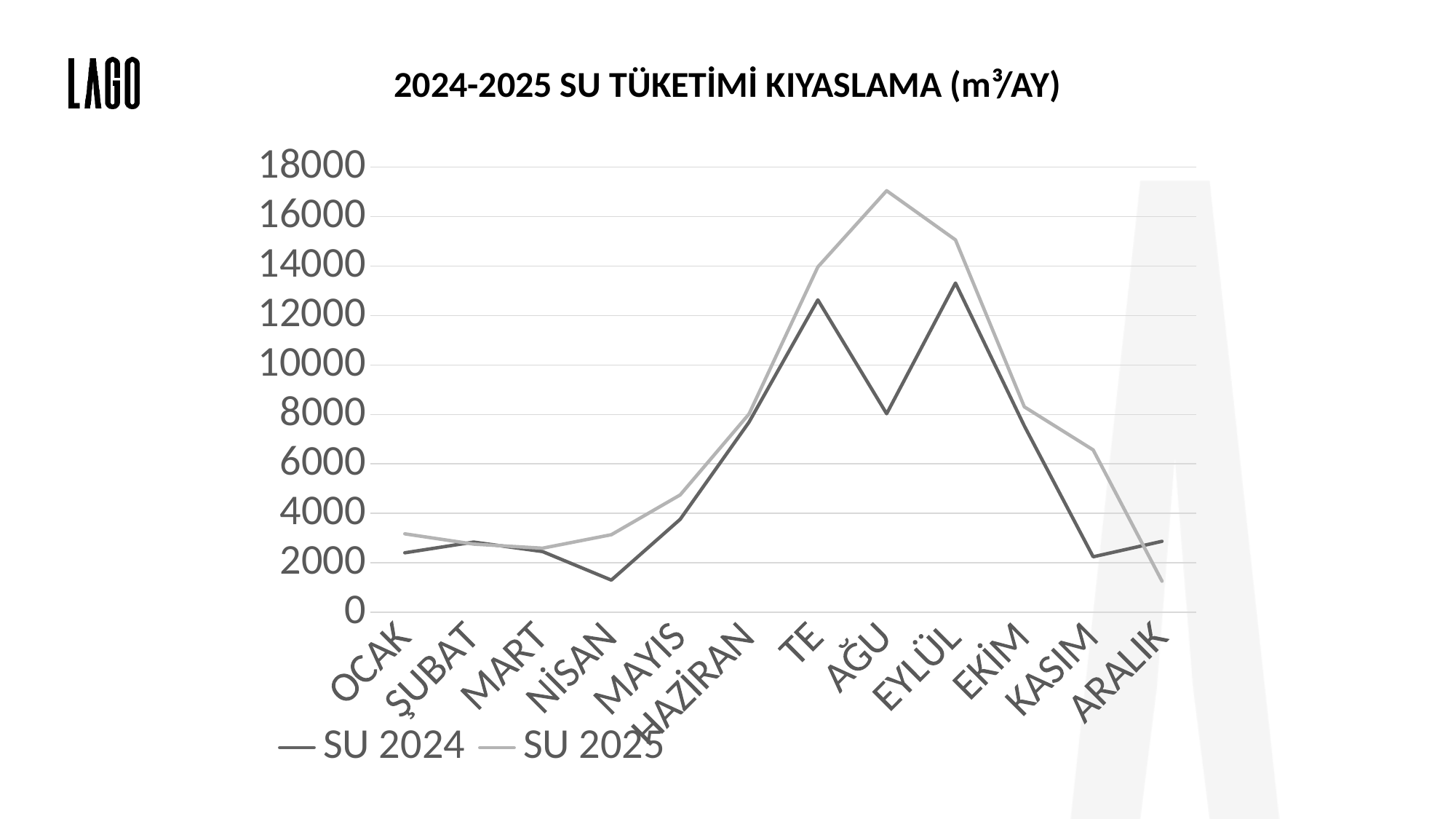
Does the SU 2024 line rise or fall from EYLÜL to KASIM? fall Is the SU 2024 value for AĞU greater or less than 10000? less Is the SU 2024 value for NİSAN greater or less than 2000? less How many categories are shown on the x axis? 12 Which category has the highest value for SU 2025? AĞU What kind of chart is shown on the slide? line chart Which category has the lowest value for SU 2025? ARALIK For KASIM, which series has the larger value, SU 2024 or SU 2025? SU 2025 How many series does the legend list? 2 Which category has the lowest value for SU 2024? NİSAN Which category has the highest value for SU 2024? EYLÜL Is the SU 2025 value for AĞU greater or less than 16000? greater